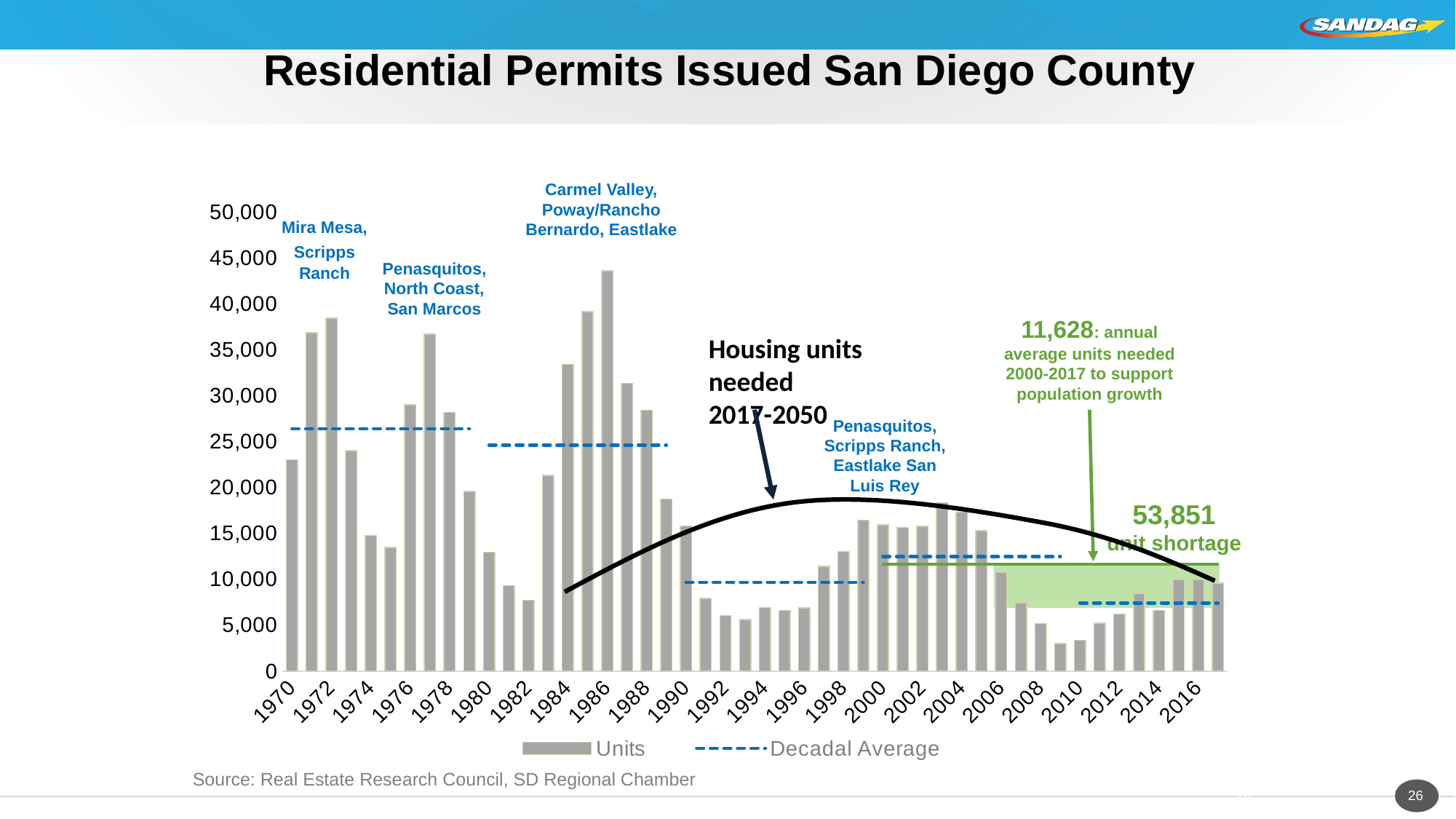
Is the value for 1982 greater or less than 10,000? less What are the two entries in the chart legend? Units and Decadal Average Do the values rise or fall from 1986 to 1992? fall Which year has the highest number of residential permits issued? 1986 Which year has the larger value, 1985 or 1986? 1986 What kind of chart is shown on the slide? Bar chart How many series does the legend list? 2 Is the value for 1970 greater or less than 20,000? greater According to the annotation, what is the annual average number of units needed 2000-2017 to support population growth? 11,628 Is the value for 1986 greater or less than 40,000? greater Which year has the larger value, 1976 or 1977? 1977